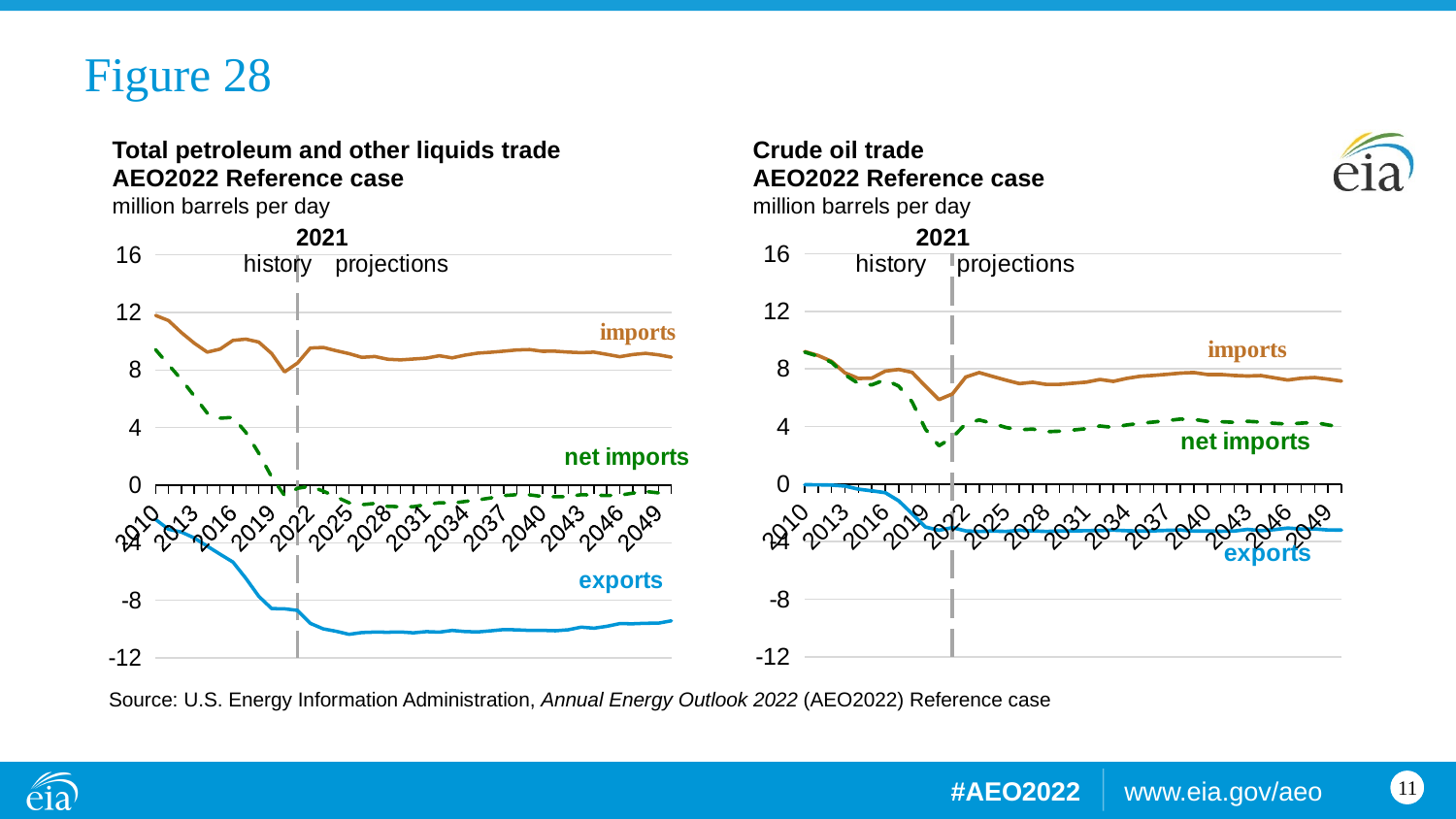
On the 'Total petroleum and other liquids trade' chart, is the value for exports in 2010 greater or less than -4? greater What kind of chart is the 'Total petroleum and other liquids trade' chart on the left? line chart How many series are plotted on the 'Crude oil trade' chart on the right? 3 On the 'Crude oil trade' chart, is the value for exports in 2049 greater or less than -4? greater On the 'Crude oil trade' chart, do net imports rise or fall between 2010 and 2021? fall On the 'Total petroleum and other liquids trade' chart, is the value for exports in 2049 greater or less than -8? less On the 'Total petroleum and other liquids trade' chart, do exports rise or fall between 2010 and 2025? fall What unit is used on the y axis of both charts? million barrels per day On the 'Crude oil trade' chart, which is larger in 2049, imports or exports? imports